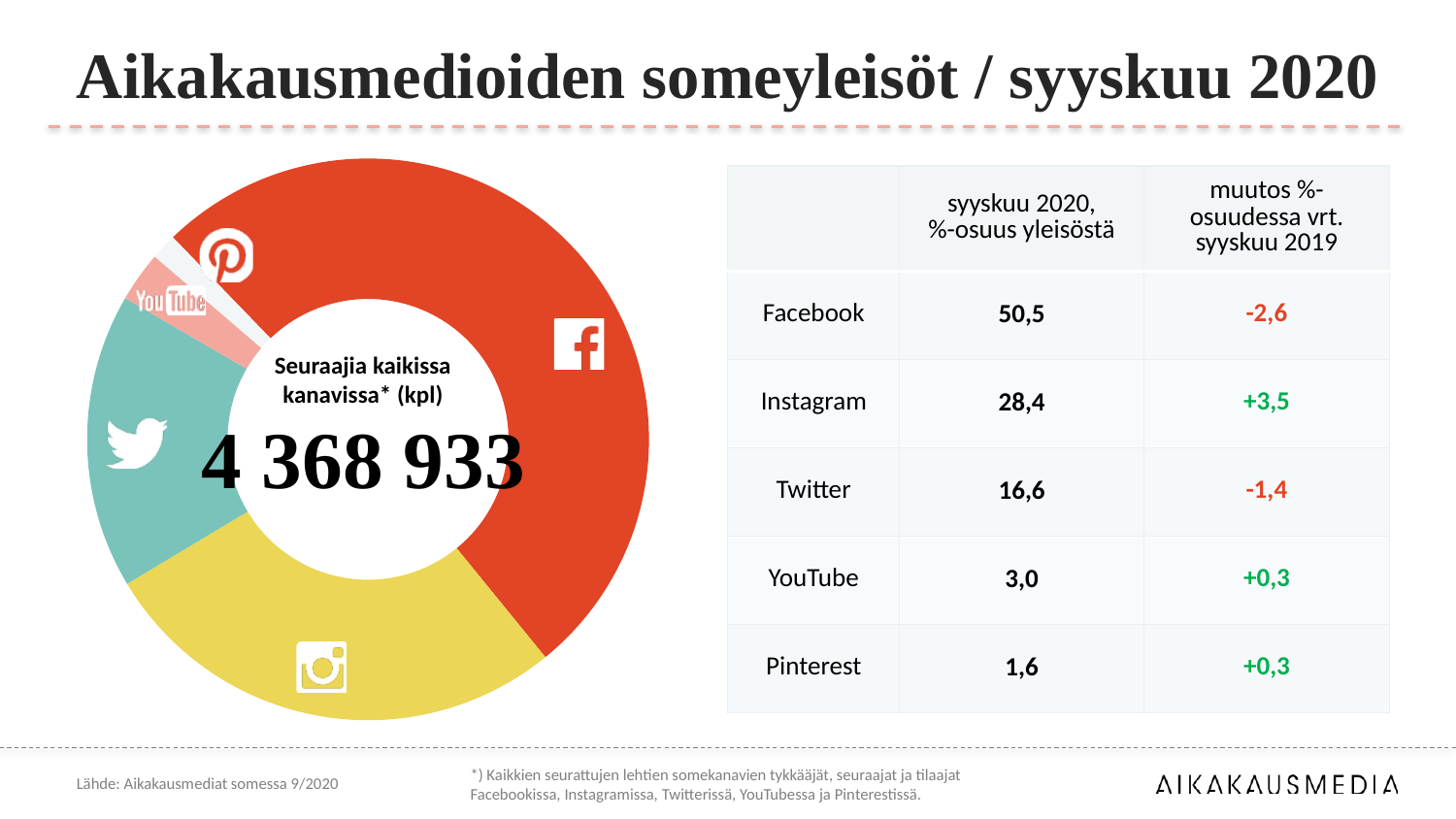
What is the title of the slide? Aikakausmedioiden someyleisöt / syyskuu 2020 What kind of chart is shown on the left of the slide? Donut (pie) chart How many channels are shown as slices in the donut chart? 5 What is the difference in percentage share between Facebook and Instagram in September 2020? 22,1 Which has a larger share of the audience, Twitter or YouTube? Twitter According to the table, what share of the audience did Twitter have in September 2020? 16,6 What is the change in Instagram's percentage share compared with September 2019? +3,5 Which channel has the largest slice of the donut chart? Facebook What is the total number of followers across all channels shown in the centre of the donut chart? 4 368 933 According to the table, what share of the audience did Instagram have in September 2020? 28,4 According to the table, what share of the audience did Facebook have in September 2020? 50,5 Which channel has the smallest slice of the donut chart? Pinterest